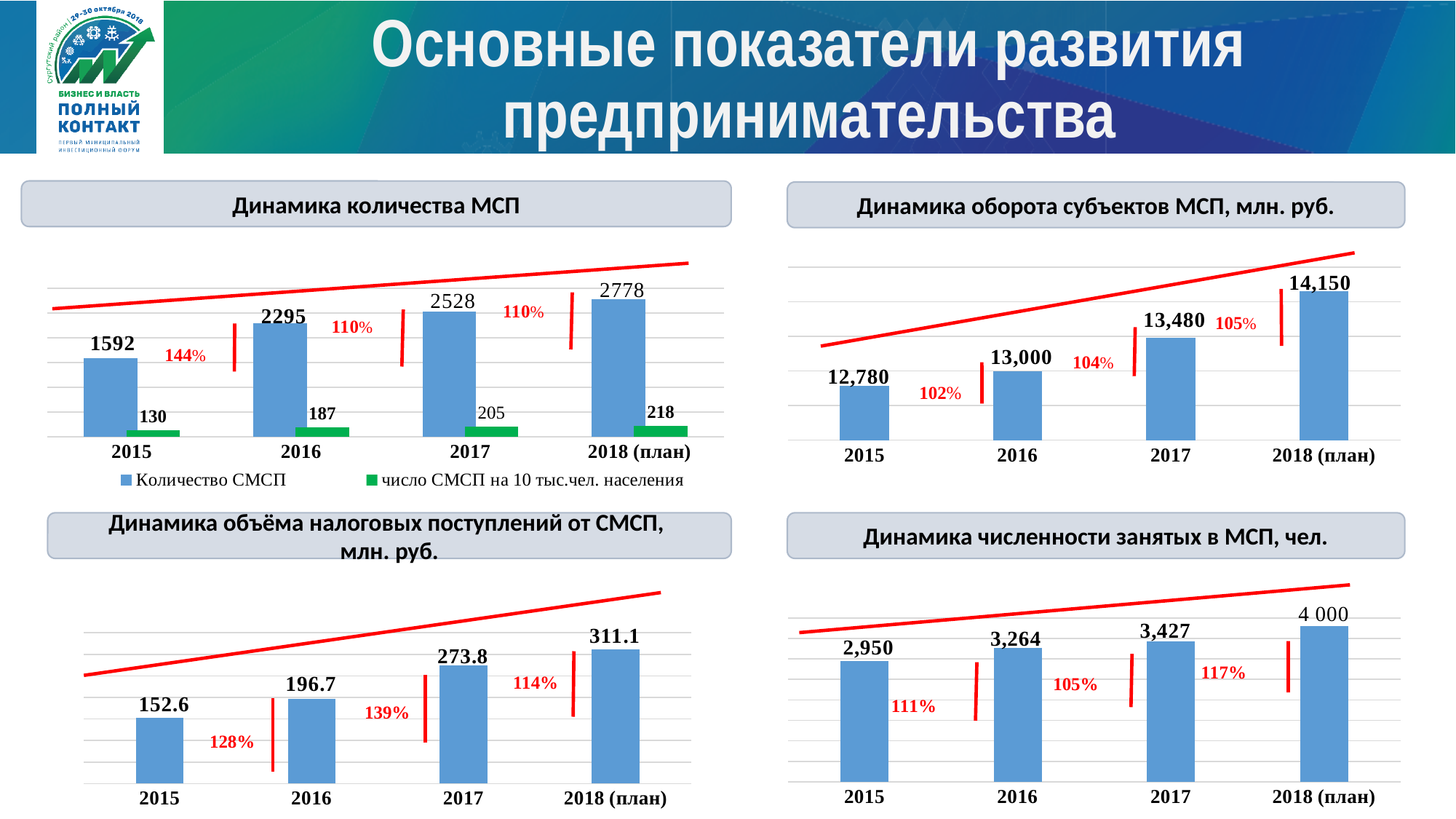
In the chart 'Динамика численности занятых в МСП, чел.', what is the value for 2016? 3,264 In the chart 'Динамика объёма налоговых поступлений от СМСП, млн. руб.', what is the value for 2018 (план)? 311.1 In the chart 'Динамика объёма налоговых поступлений от СМСП, млн. руб.', do the values rise or fall from 2015 to 2018 (план)? rise In the chart 'Динамика численности занятых в МСП, чел.', which year has the highest value? 2018 (план) In the chart 'Динамика количества МСП', what is the difference between the 'Количество СМСП' values for 2018 (план) and 2015? 1186 How many categories are shown on the x axis of the chart 'Динамика оборота субъектов МСП, млн. руб.'? 4 In the chart 'Динамика количества МСП', what is the value of 'Количество СМСП' for 2016? 2295 What type of chart is 'Динамика численности занятых в МСП, чел.'? bar chart In the chart 'Динамика количества МСП', what is the value of 'число СМСП на 10 тыс.чел. населения' for 2017? 205 In the chart 'Динамика оборота субъектов МСП, млн. руб.', which year has the lowest value? 2015 How many series does the legend of the chart 'Динамика количества МСП' list? 2 In the chart 'Динамика оборота субъектов МСП, млн. руб.', what is the value for 2017? 13,480